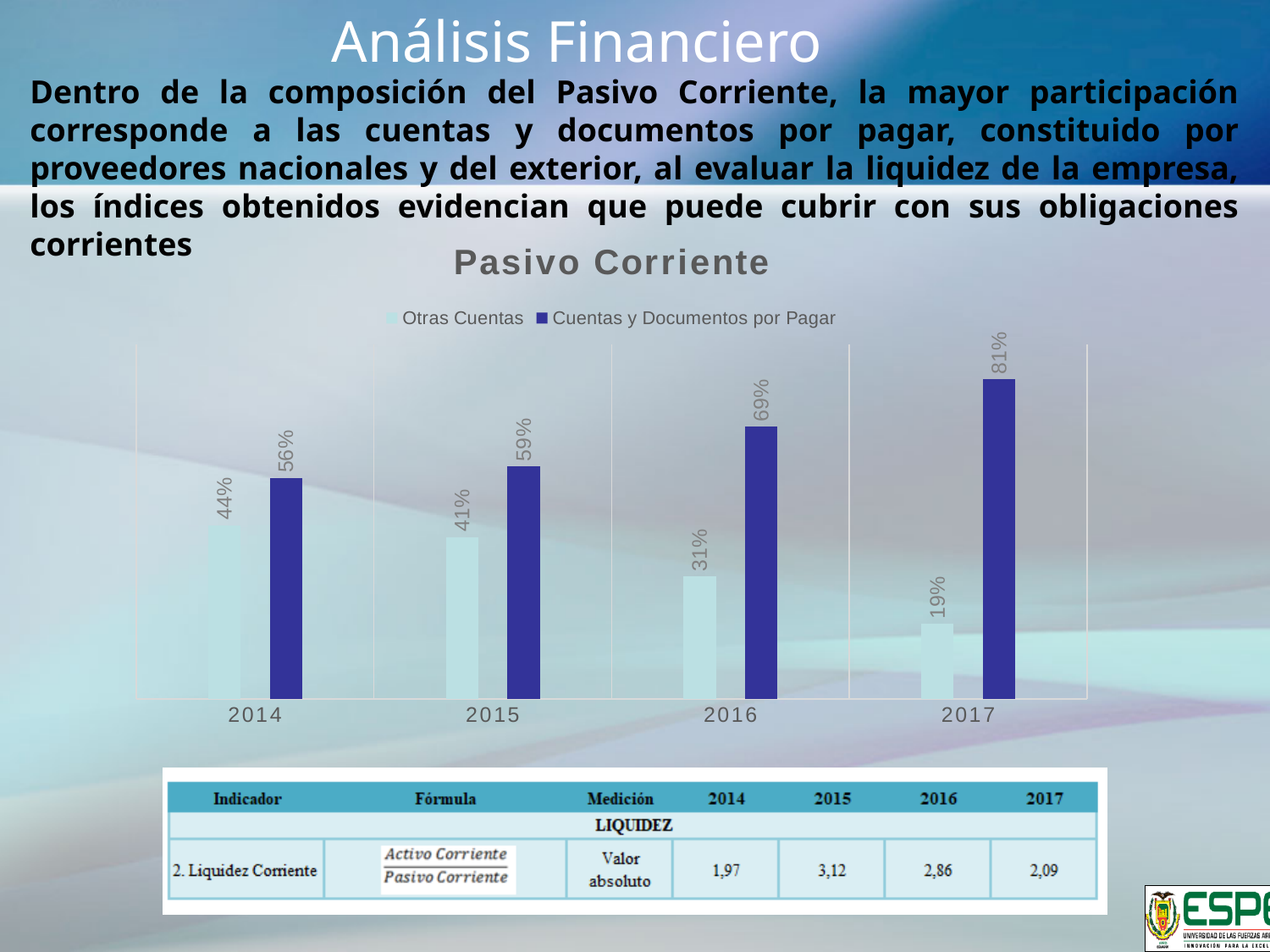
In which year is Otras Cuentas lowest? 2017 What is the value for Otras Cuentas in 2014? 44% What is the value for Cuentas y Documentos por Pagar in 2017? 81% What is the title of the chart? Pasivo Corriente How many years are shown on the x axis of the chart? 4 What is the difference between Cuentas y Documentos por Pagar and Otras Cuentas in 2015? 18% Does the value for Cuentas y Documentos por Pagar rise or fall from 2014 to 2017? Rise What is the value for Otras Cuentas in 2016? 31% What kind of chart is shown? Bar chart Which is larger in 2016, Otras Cuentas or Cuentas y Documentos por Pagar? Cuentas y Documentos por Pagar How many series does the legend list? 2 In which year is Cuentas y Documentos por Pagar highest? 2017